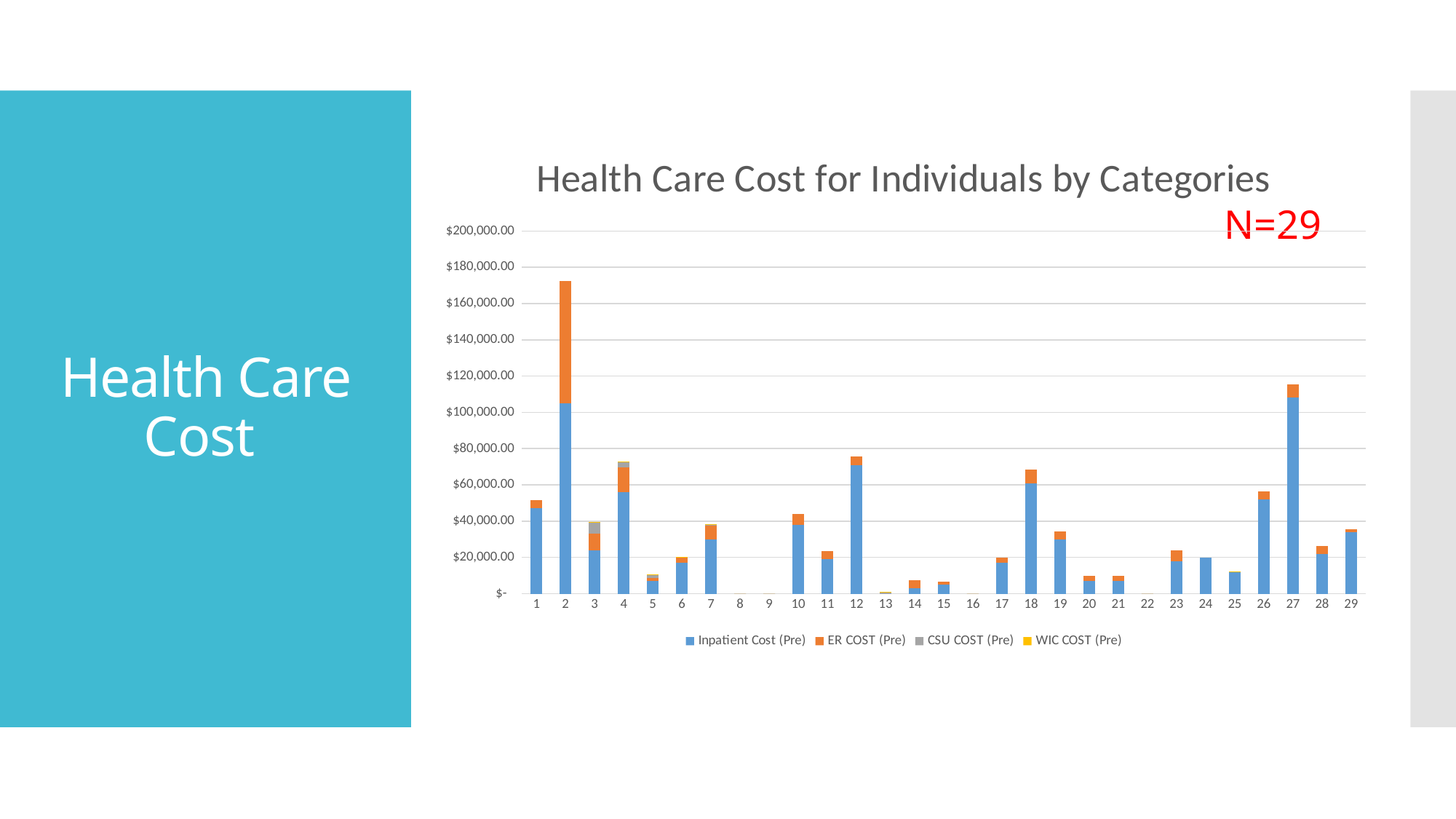
Which individual has a larger total cost, 27 or 12? 27 What type of chart is shown on the slide? Bar chart Which series is shown in orange in the legend? ER COST (Pre) Which individual has the highest total health care cost? 2 Is the total cost for individual 27 greater or less than $120,000.00? less Which individual has a larger total cost, 18 or 19? 18 Is the total cost for individual 2 greater or less than $160,000.00? greater How many series does the legend list? 4 How many individuals (categories) are shown on the x axis? 29 What is the title of the chart? Health Care Cost for Individuals by Categories Is the total cost for individual 25 greater or less than $20,000.00? less